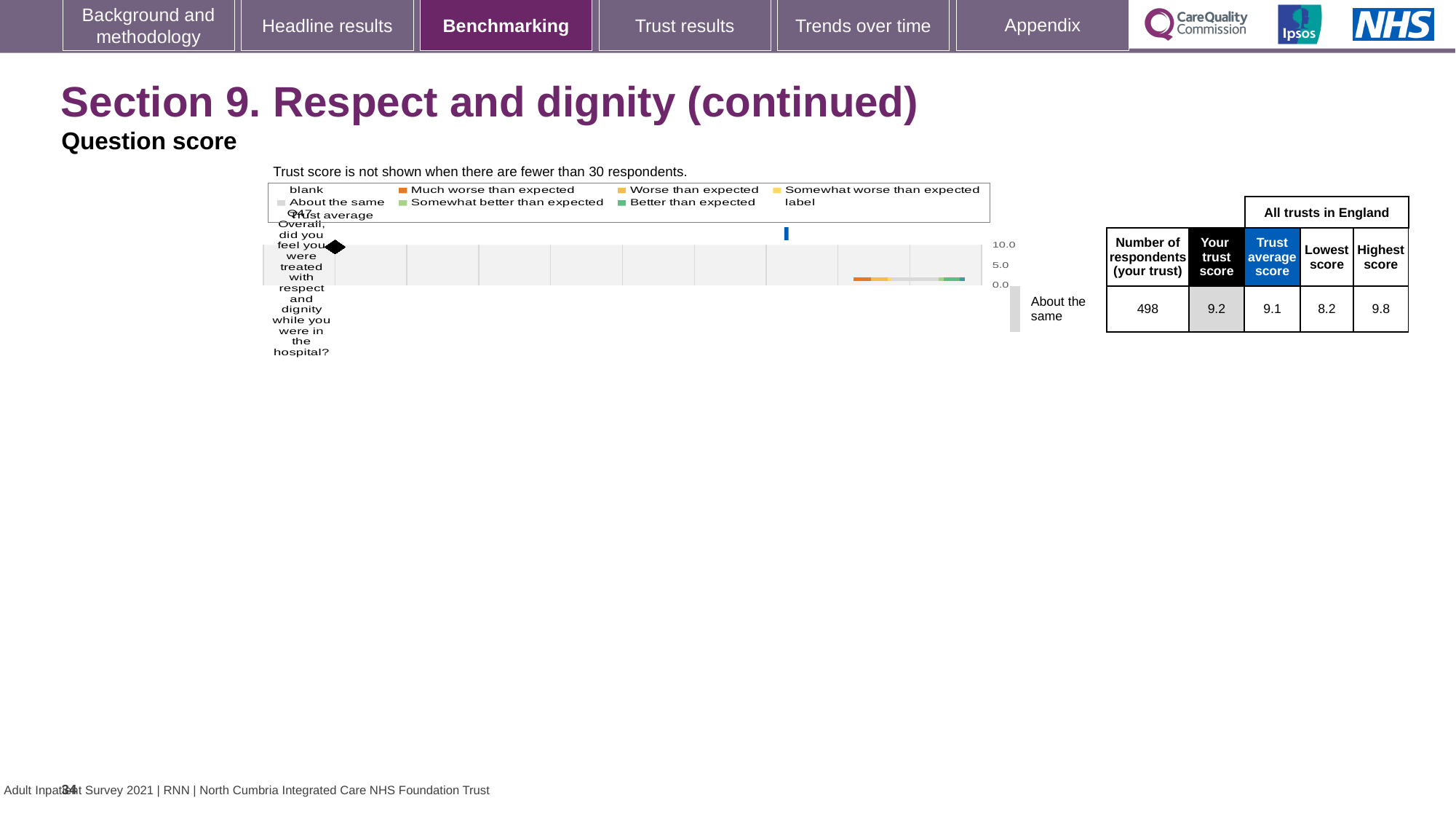
What is the difference between the highest score and the lowest score for Q47? 1.6 What is the lowest score for Q47 among all trusts in England? 8.2 What is the trust average score for Q47 across all trusts in England? 9.1 Which survey question is plotted in the chart? Q47 Overall, did you feel you were treated with respect and dignity while you were in the hospital? Is the trust's score for Q47 greater or less than 5.0? greater What is the trust's score for Q47? 9.2 How many respondents from the trust answered Q47? 498 What kind of chart is used to show the Q47 score? Bar chart What is the highest score for Q47 among all trusts in England? 9.8 Which is larger for Q47: the trust's score or the trust average score? The trust's score (9.2) What is the highest value shown on the chart's score axis? 10.0 What benchmark category is shown for Q47 next to the chart? About the same